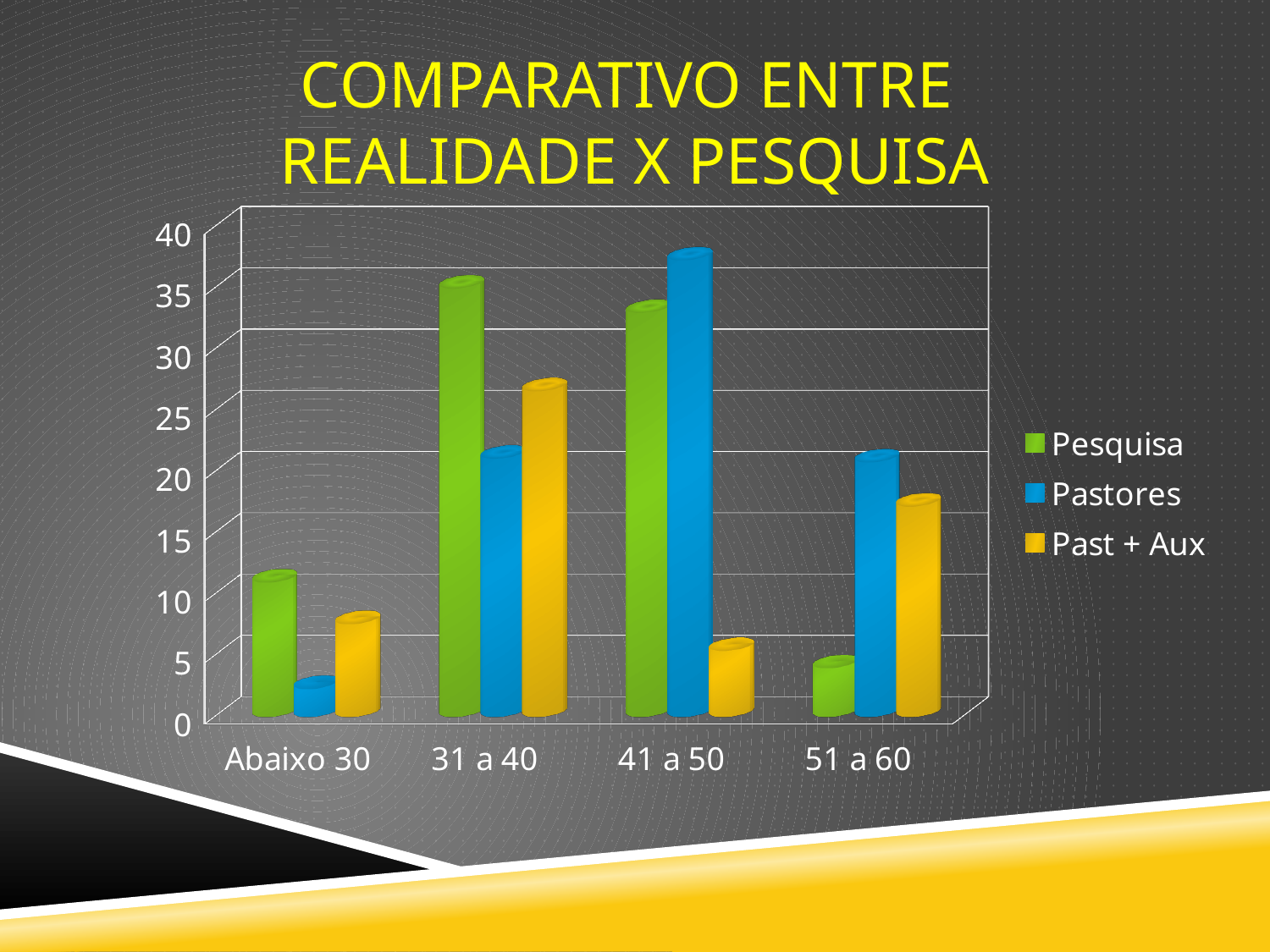
Is the Past + Aux value for 51 a 60 greater or less than 15? greater Is the Pesquisa value for 31 a 40 greater or less than 30? greater For which category is the Pesquisa value lowest? 51 a 60 For which category is the Pastores value highest? 41 a 50 How many age categories are shown on the x axis? 4 How many series does the legend list? 3 What colour represents the Pastores series? blue For which category is the Past + Aux value highest? 31 a 40 What kind of chart is shown on the slide? bar chart In the 31 a 40 category, which is larger: Pesquisa or Pastores? Pesquisa Is the Pastores value for Abaixo 30 greater or less than 5? less In the 41 a 50 category, which is larger: Pastores or Past + Aux? Pastores